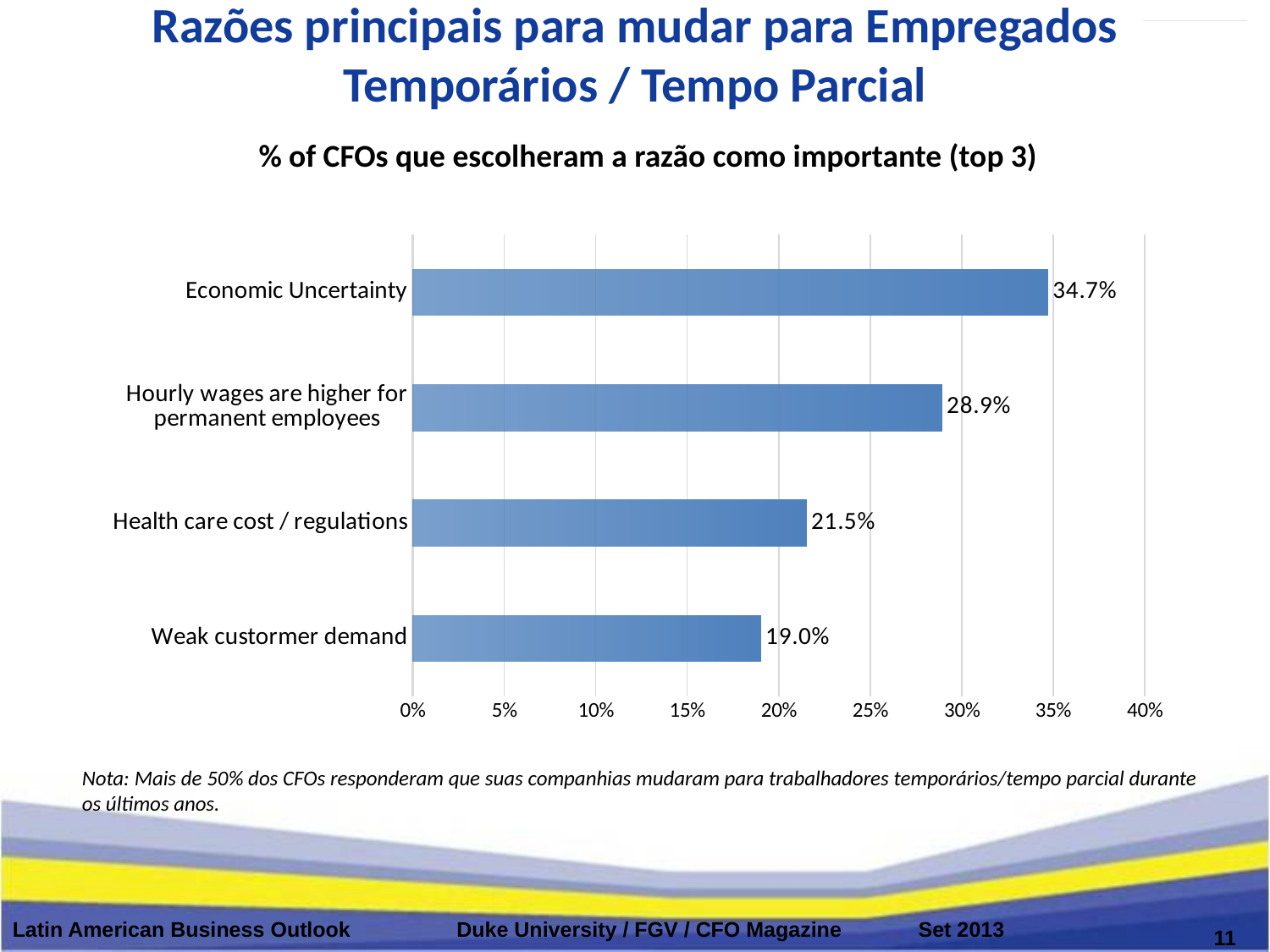
Which reason has the highest percentage? Economic Uncertainty What percentage of CFOs chose Economic Uncertainty as an important reason? 34.7% What is the difference between Hourly wages are higher for permanent employees and Health care cost / regulations? 7.4% What is the value for Health care cost / regulations? 21.5% Which is larger: Health care cost / regulations or Weak custormer demand? Health care cost / regulations What is the value for Weak custormer demand? 19.0% Which reason has the lowest percentage? Weak custormer demand What is the difference between Economic Uncertainty and Weak custormer demand? 15.7% How many reasons are shown in the chart? 4 What is the subtitle above the chart? % of CFOs que escolheram a razão como importante (top 3) What kind of chart is shown on the slide? Bar chart What is the value for Hourly wages are higher for permanent employees? 28.9%